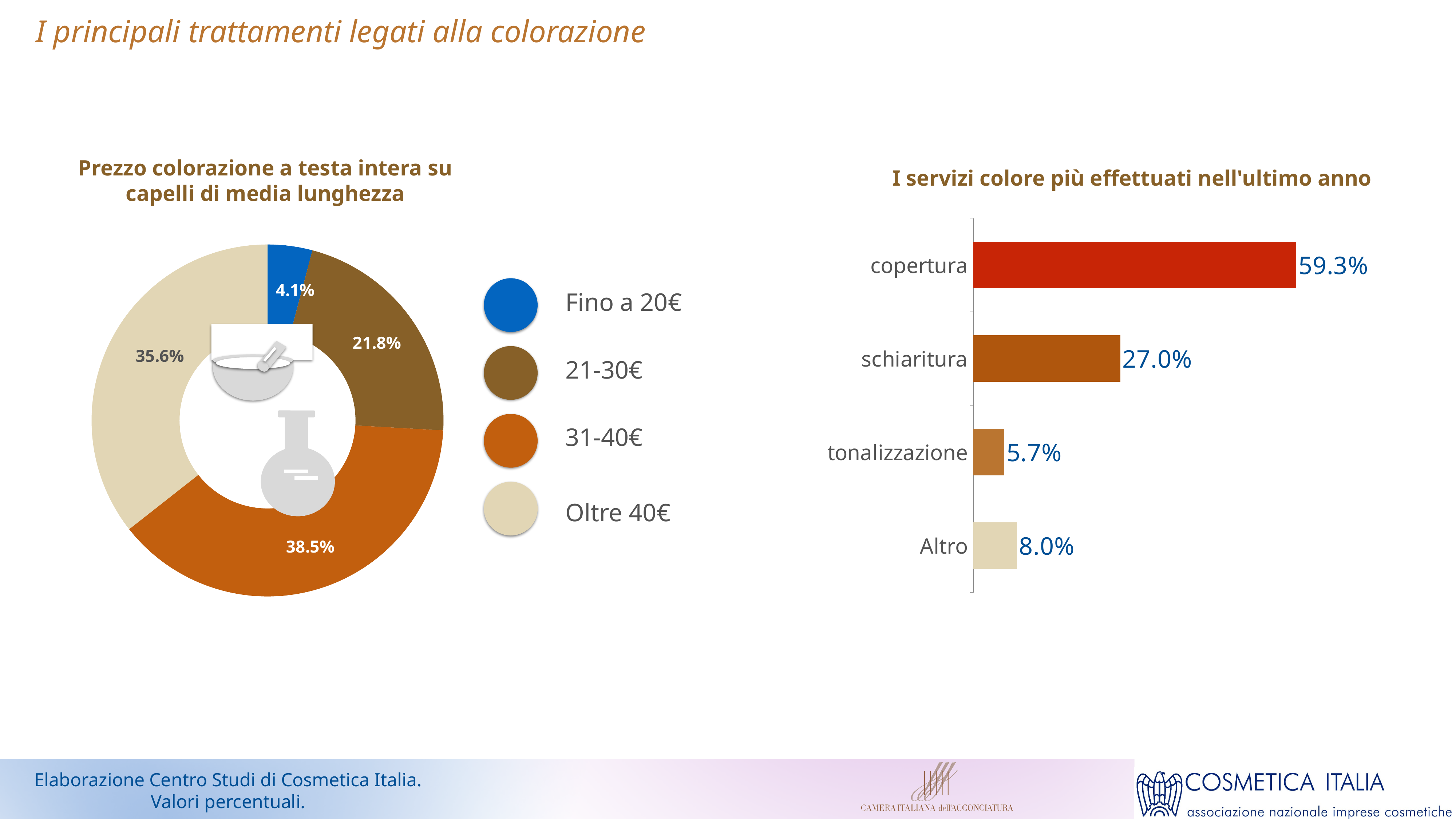
What kind of chart is 'I servizi colore più effettuati nell'ultimo anno'? Bar chart In the chart 'Prezzo colorazione a testa intera su capelli di media lunghezza', what share is shown for 'Fino a 20€'? 4.1% In the chart 'Prezzo colorazione a testa intera su capelli di media lunghezza', how many price bands does the legend list? 4 In the chart 'I servizi colore più effettuati nell'ultimo anno', which service has the lowest value? tonalizzazione In the chart 'Prezzo colorazione a testa intera su capelli di media lunghezza', what share is shown for '31-40€'? 38.5% In the chart 'I servizi colore più effettuati nell'ultimo anno', what is the value for 'schiaritura'? 27.0% In the chart 'I servizi colore più effettuati nell'ultimo anno', what is the difference between 'copertura' and 'schiaritura'? 32.3% In the chart 'I servizi colore più effettuati nell'ultimo anno', which service has the highest value? copertura In the chart 'Prezzo colorazione a testa intera su capelli di media lunghezza', what is the difference between the shares for 'Oltre 40€' and '21-30€'? 13.8% What kind of chart is 'Prezzo colorazione a testa intera su capelli di media lunghezza'? Doughnut chart In the chart 'Prezzo colorazione a testa intera su capelli di media lunghezza', which price band has the smallest share? Fino a 20€ In the chart 'Prezzo colorazione a testa intera su capelli di media lunghezza', which price band has the largest share? 31-40€